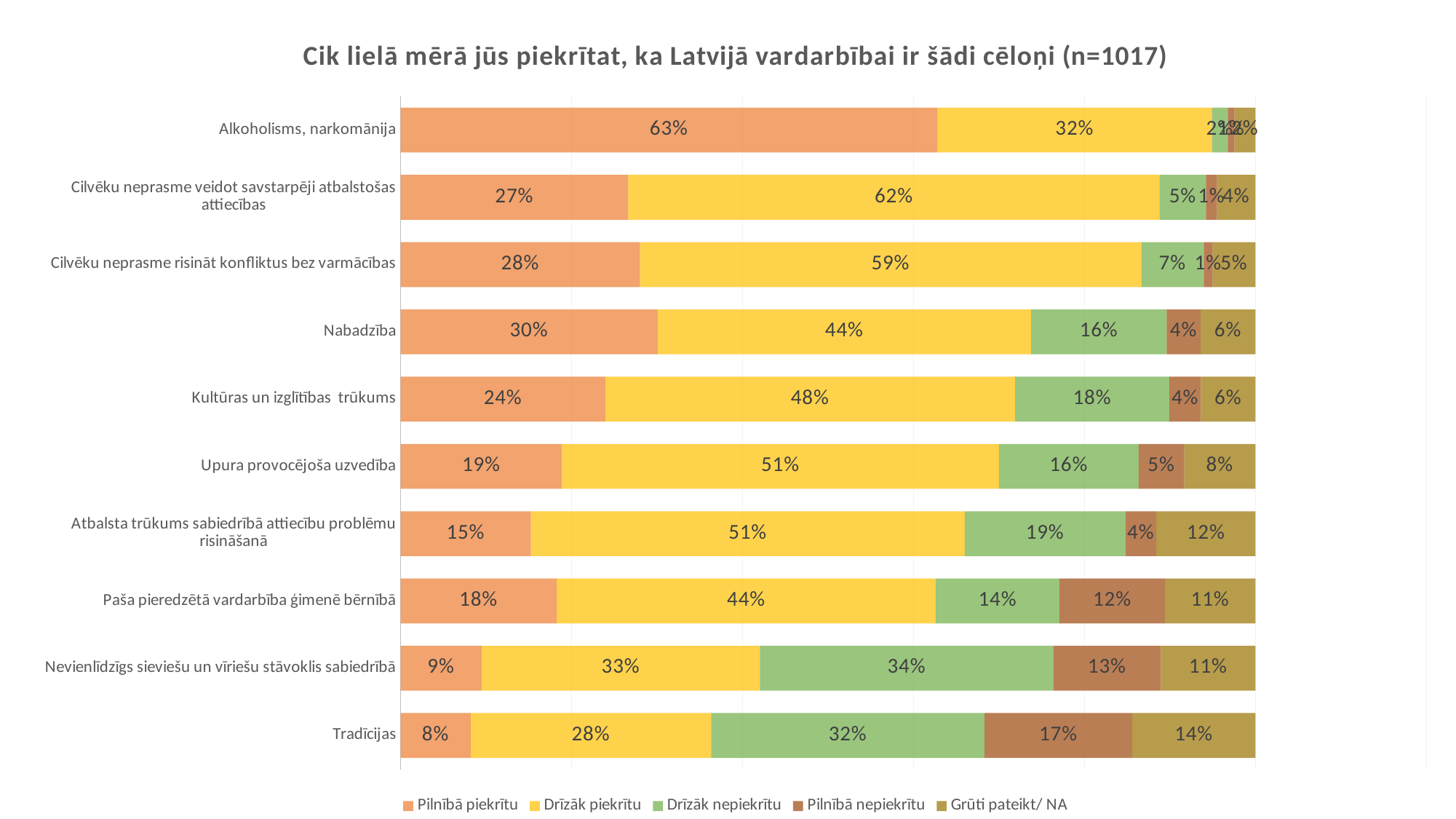
What is the difference between the 'Pilnībā nepiekrītu' values for 'Tradīcijas' and 'Paša pieredzētā vardarbība ģimenē bērnībā'? 5% What kind of chart is shown on the slide? Stacked bar chart What is the 'Pilnībā piekrītu' value for 'Alkoholisms, narkomānija'? 63% What is the 'Drīzāk piekrītu' value for 'Cilvēku neprasme veidot savstarpēji atbalstošas attiecības'? 62% What is the 'Grūti pateikt/ NA' value for 'Tradīcijas'? 14% Which legend entry is shown in green? Drīzāk nepiekrītu How many series does the legend list? 5 Which category has the lowest 'Pilnībā piekrītu' value? Tradīcijas Which is larger: the 'Drīzāk nepiekrītu' value for 'Nabadzība' or for 'Kultūras un izglītības trūkums'? Kultūras un izglītības trūkums What is the 'Drīzāk nepiekrītu' value for 'Nevienlīdzīgs sieviešu un vīriešu stāvoklis sabiedrībā'? 34% How many categories (causes) are listed on the chart? 10 Which category has the highest 'Pilnībā piekrītu' value? Alkoholisms, narkomānija